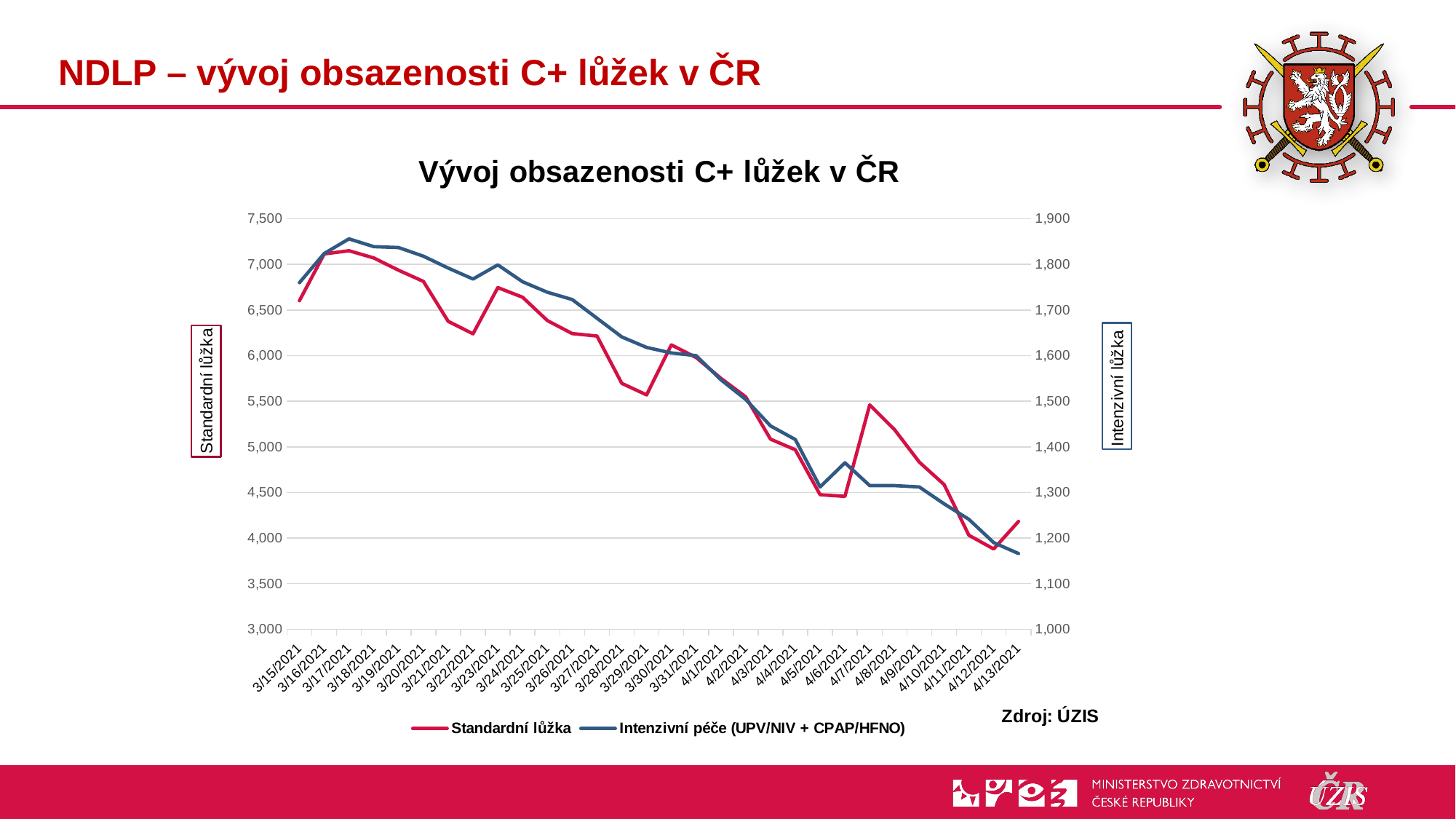
On which date does the Intenzivní péče (UPV/NIV + CPAP/HFNO) series reach its lowest value? 4/13/2021 On which date does the Standardní lůžka series reach its lowest value? 4/12/2021 On which date does the Standardní lůžka series reach its highest value? 3/17/2021 Is the value for Intenzivní péče (UPV/NIV + CPAP/HFNO) on 3/17/2021 greater or less than 1,800? greater Is the value for Standardní lůžka on 4/13/2021 greater or less than 4,500? less How many series does the legend list? 2 How many dates are plotted along the x axis? 30 What kind of chart is shown on the slide? Line chart What is the label of the right-hand vertical axis? Intenzivní lůžka Do the values for Standardní lůžka generally rise or fall from 3/15/2021 to 4/13/2021? Fall What is the title of the chart? Vývoj obsazenosti C+ lůžek v ČR Which is larger for Standardní lůžka: the value on 3/17/2021 or the value on 4/12/2021? 3/17/2021